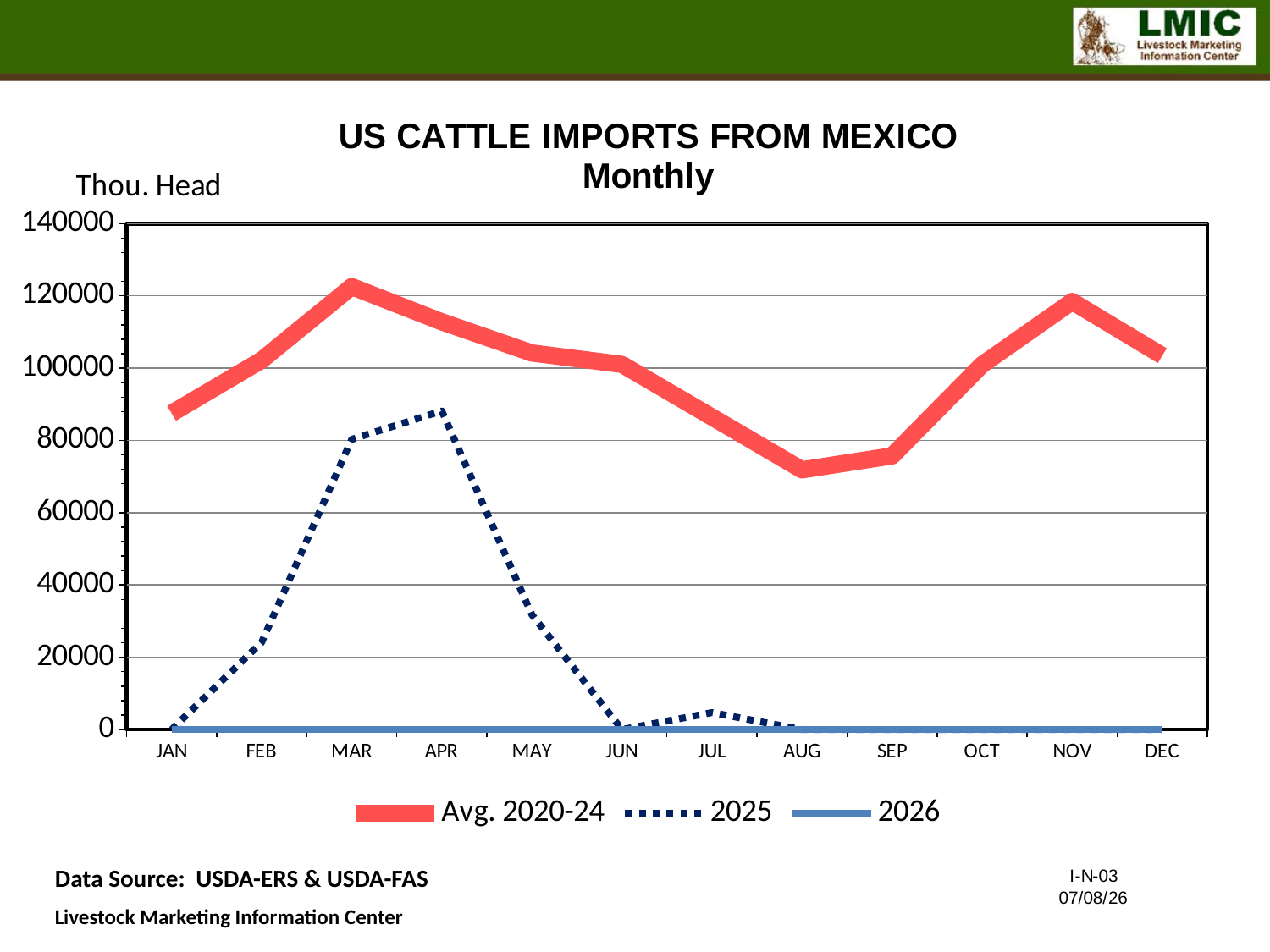
How many months are plotted along the x axis? 12 In APR, which series has the larger value, Avg. 2020-24 or 2025? Avg. 2020-24 How many series does the legend list? 3 What kind of chart is shown on the slide? line chart What unit label is shown above the y axis? Thou. Head In which month does the 2025 series reach its highest value? APR Is the Avg. 2020-24 value for AUG greater or less than 80000? less Does the 2025 series rise or fall from APR to JUN? fall Does the Avg. 2020-24 series rise or fall from AUG to NOV? rise Is the 2025 value for MAR greater or less than 60000? greater Is the Avg. 2020-24 value for MAR greater or less than 100000? greater